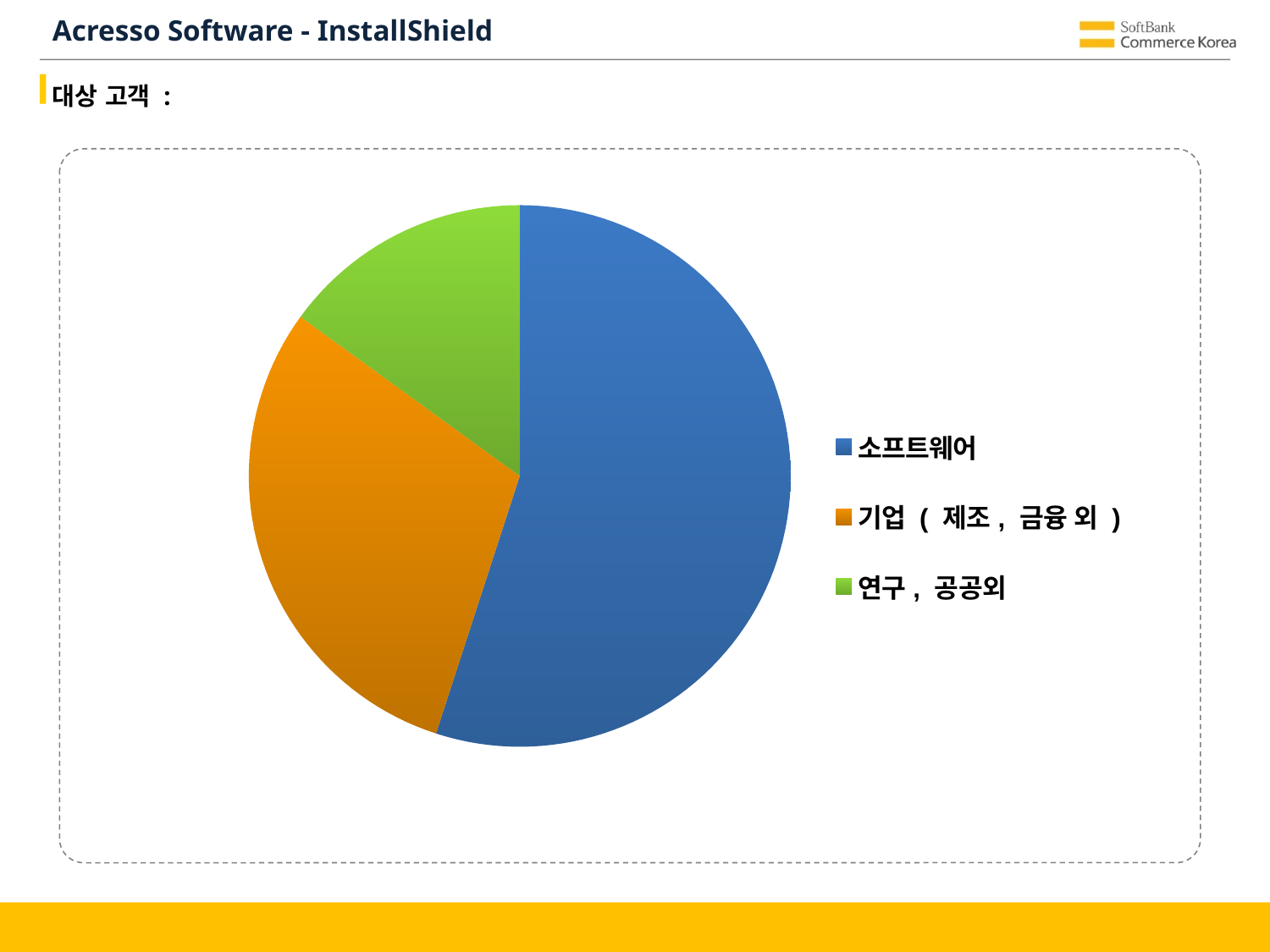
What colour is the 소프트웨어 slice in the pie chart? blue How many slices does the pie chart have? 3 Which slice is larger, 기업 ( 제조 , 금융 외 ) or 연구 , 공공외? 기업 ( 제조 , 금융 외 ) What kind of chart is shown on the slide? pie chart Which category has the largest slice of the pie chart? 소프트웨어 Which slice is smaller, 소프트웨어 or 연구 , 공공외? 연구 , 공공외 Which slice is larger, 소프트웨어 or 기업 ( 제조 , 금융 외 )? 소프트웨어 Which category is shown in green in the pie chart? 연구 , 공공외 How many entries does the legend of the pie chart list? 3 Which category has the smallest slice of the pie chart? 연구 , 공공외